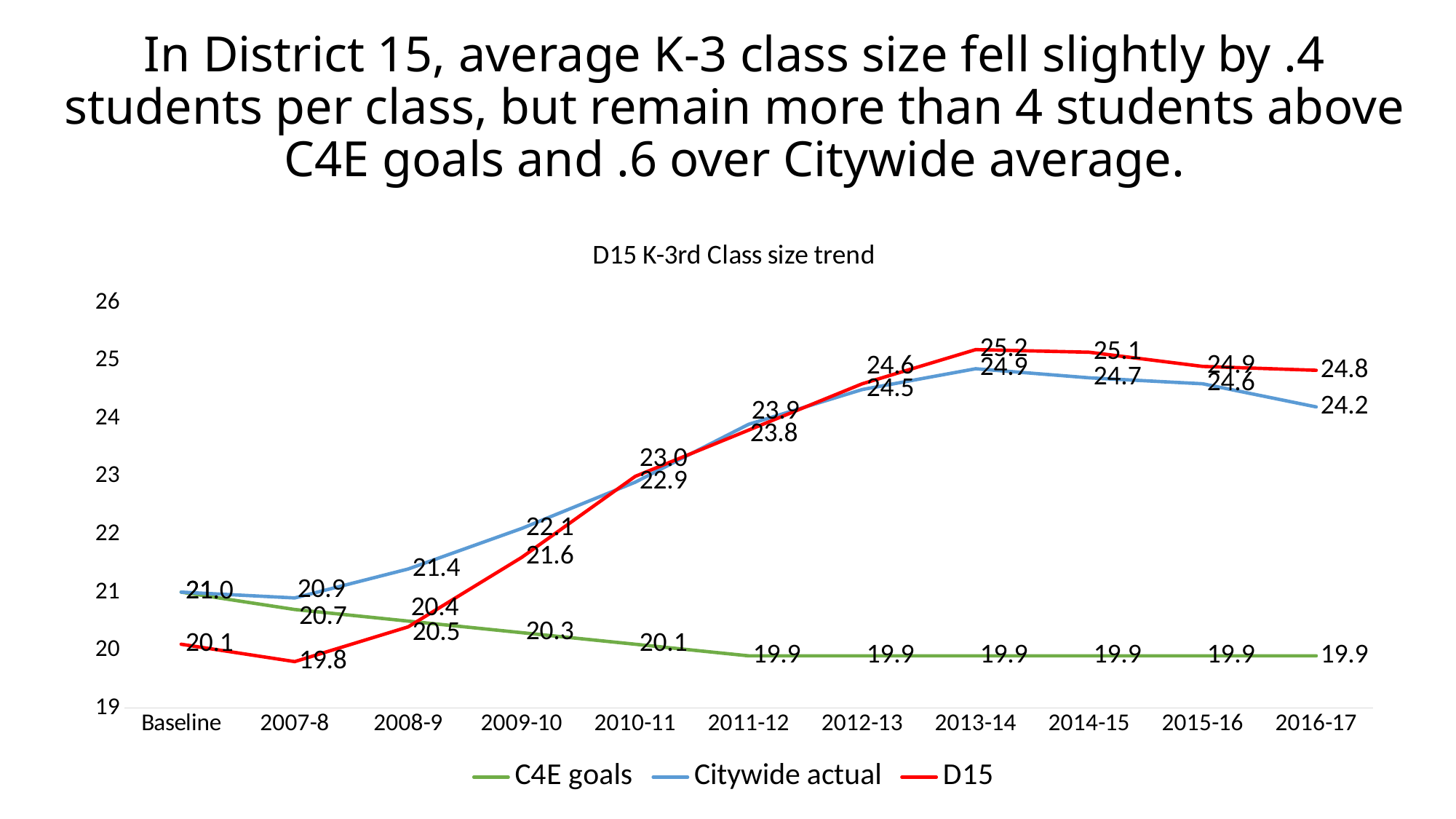
How many time points are plotted along the x axis? 11 Which is larger in 2016-17, the D15 value or the C4E goals value? D15 Does the C4E goals series rise or fall from Baseline to 2016-17? fall In which year is the D15 series at its lowest value? 2007-8 How many series does the legend list? 3 What is the C4E goals value for 2009-10? 20.3 What is the title of the chart? D15 K-3rd Class size trend What is the D15 value for 2016-17? 24.8 In which year does the D15 series reach its highest value? 2013-14 What type of chart is shown on the slide? line chart What is the difference between the D15 value and the Citywide actual value in 2016-17? 0.6 What is the Citywide actual value for 2016-17? 24.2